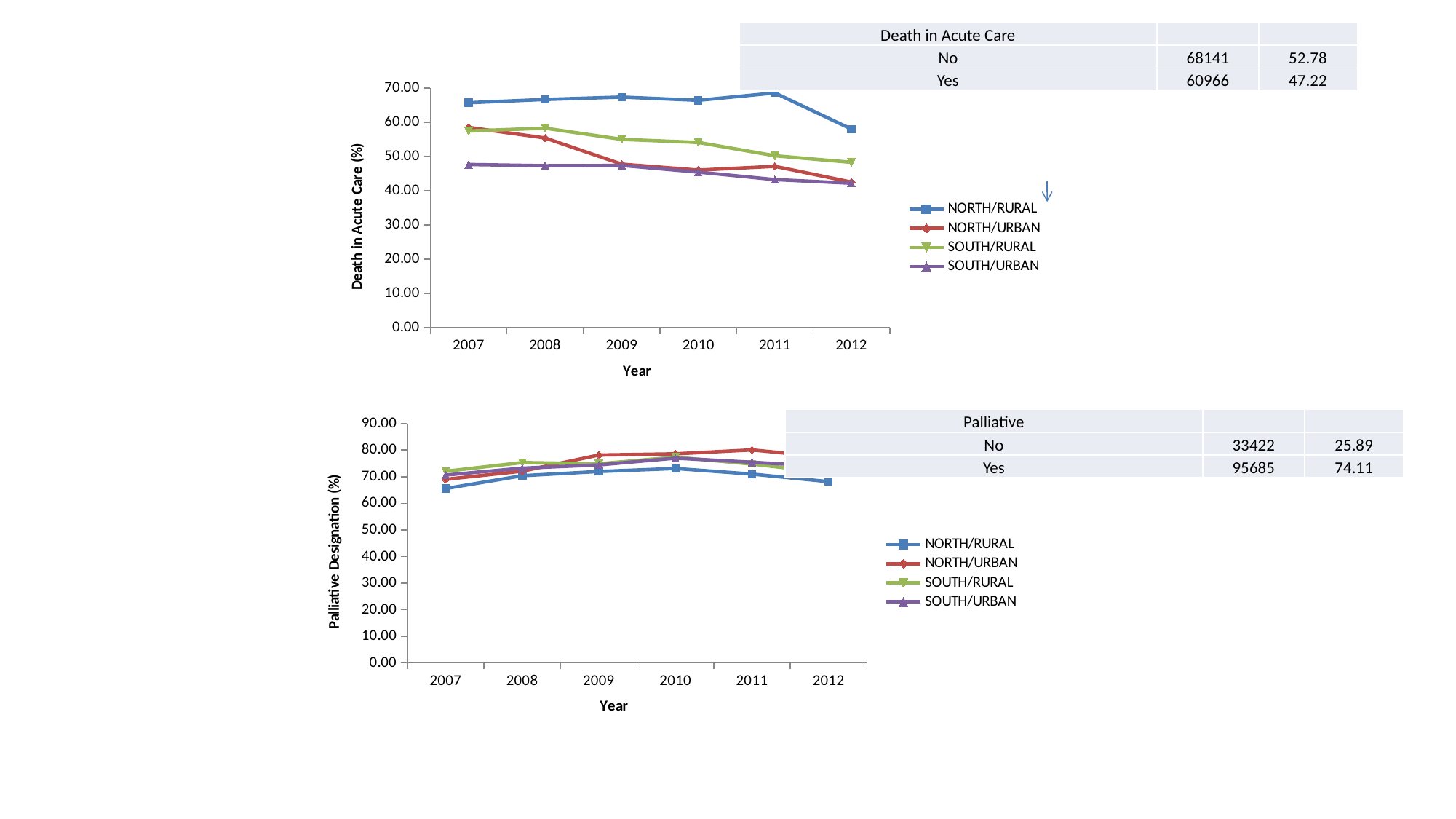
In the top chart (Death in Acute Care), does the SOUTH/RURAL series rise or fall from 2007 to 2012? Fall How many years are shown on the x axis of the bottom chart (Palliative Designation)? 6 In the bottom chart (Palliative Designation), is the value for NORTH/URBAN in 2011 greater or less than 70.00? greater In the bottom chart (Palliative Designation), which series has the lowest value in 2007? NORTH/RURAL In the top chart (Death in Acute Care), is the value for NORTH/RURAL in 2007 greater or less than 60.00? greater What is the y-axis label of the bottom chart? Palliative Designation (%) In the top chart (Death in Acute Care), which is larger in 2009: NORTH/RURAL or NORTH/URBAN? NORTH/RURAL How many series does the legend of the top chart (Death in Acute Care) list? 4 In the bottom chart (Palliative Designation), which is larger in 2007: NORTH/RURAL or SOUTH/RURAL? SOUTH/RURAL In the top chart (Death in Acute Care), which series has the highest value in 2011? NORTH/RURAL What kind of chart is the top chart (Death in Acute Care)? Line chart In the top chart (Death in Acute Care), is the value for SOUTH/URBAN in 2012 greater or less than 50.00? less